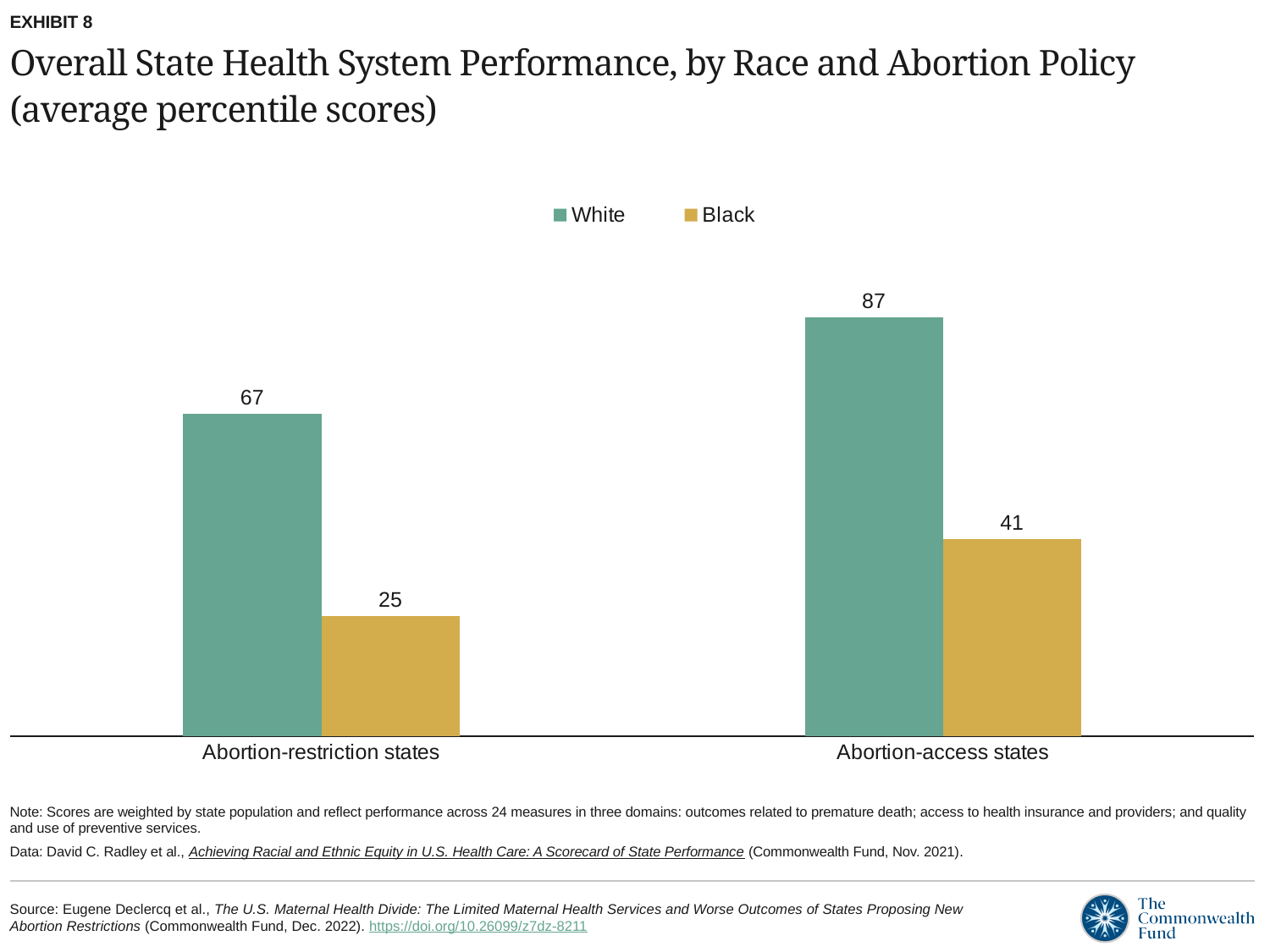
What is the average percentile score for Black in abortion-access states? 41 What is the difference between the White scores in abortion-access states and abortion-restriction states? 20 Which category has the highest White score? Abortion-access states Which is larger: the Black score in abortion-access states or the Black score in abortion-restriction states? Abortion-access states What is the average percentile score for Black in abortion-restriction states? 25 Which category has the lowest Black score? Abortion-restriction states How many categories are shown on the x axis? 2 What kind of chart is shown on the slide? Bar chart What is the difference between the White and Black scores in abortion-access states? 46 What is the average percentile score for White in abortion-restriction states? 67 How many series does the legend list? 2 Which series is shown in gold/yellow bars? Black